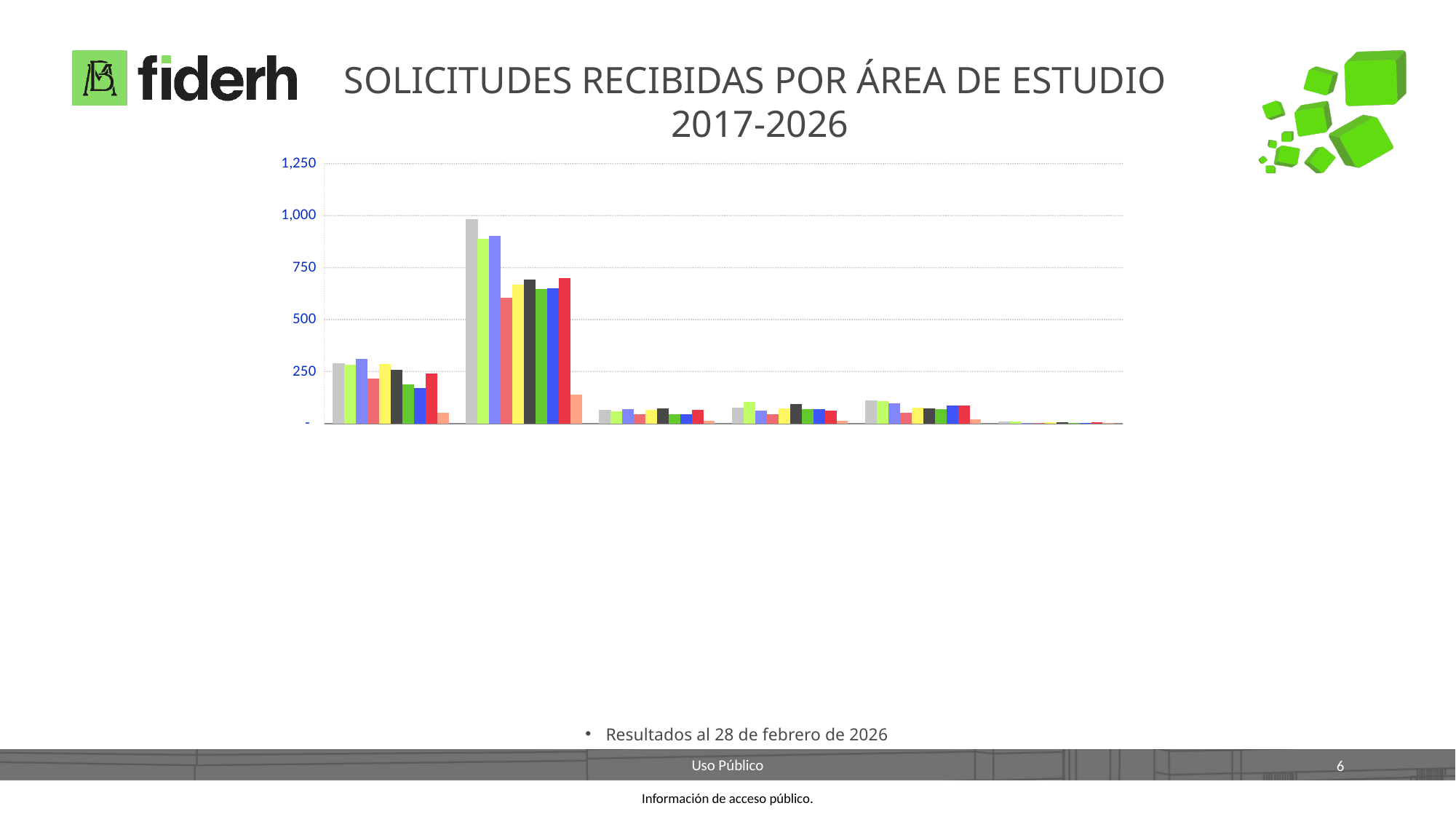
Which group of bars, counted from the left, contains the tallest bar in the chart? the second group What is the title of the chart on the slide? SOLICITUDES RECIBIDAS POR ÁREA DE ESTUDIO 2017-2026 Which group of bars, counted from the left, has the lowest values in the chart? the sixth group What is the highest value shown on the vertical axis? 1,250 What kind of chart is shown on the slide? bar chart Which has taller bars overall, the first group from the left or the fourth group from the left? the first group How many bars are there in each group of the chart? 10 Is the tallest bar in the second group from the left greater or less than 750? greater How many groups of bars (categories) are plotted along the x axis? 6 Is the tallest bar in the first group from the left greater or less than 500? less Are the bars in the third group from the left greater or less than 250? less